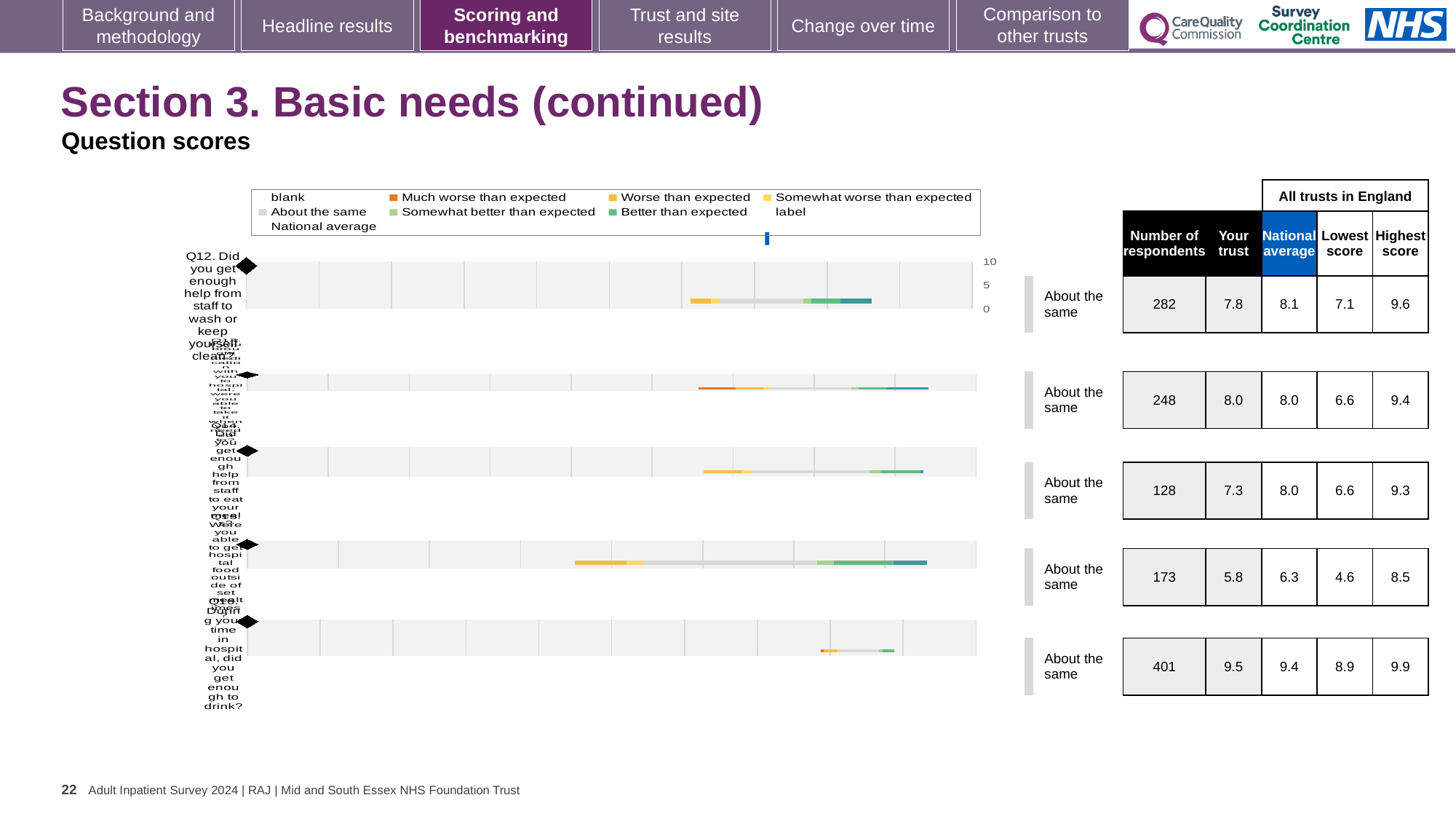
What kind of chart is shown on the slide? bar chart What is the lowest 'Your trust' score shown in the table? 5.8 For Q12, how many respondents are listed in the table? 282 How many question bars are plotted in the chart? 5 In the chart legend, what colour represents 'Much worse than expected'? orange What is the highest 'Your trust' score shown in the table? 9.5 For Q12 (help from staff to wash or keep yourself clean), what is the 'Your trust' score in the table? 7.8 For Q12, what is the highest score among all trusts in England? 9.6 For Q12, which is larger: the 'Your trust' score or the national average? national average For Q12, what is the national average score? 8.1 For Q12, what is the difference between the national average (8.1) and the 'Your trust' score (7.8)? 0.3 In the chart legend, what colour represents 'Better than expected'? green